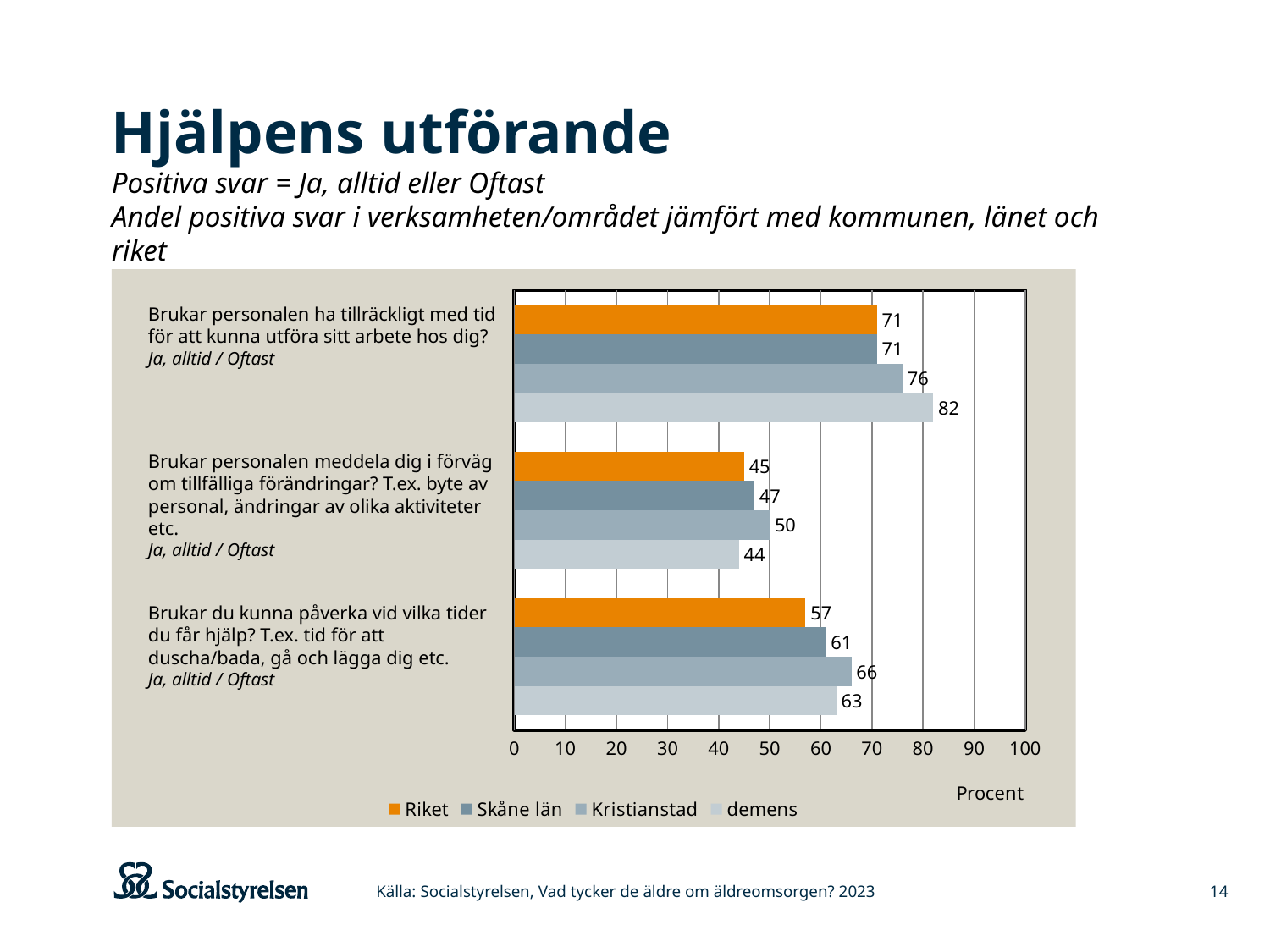
What is the difference between the 'demens' and 'Riket' values on the question 'Brukar personalen ha tillräckligt med tid för att kunna utföra sitt arbete hos dig?' 11 Which series has the highest value on the question 'Brukar personalen ha tillräckligt med tid för att kunna utföra sitt arbete hos dig?' demens What is the value for 'Kristianstad' on the question 'Brukar personalen meddela dig i förväg om tillfälliga förändringar?' 50 What is the value for 'Riket' on the question 'Brukar du kunna påverka vid vilka tider du får hjälp?' 57 Which series has the lowest value on the question 'Brukar personalen meddela dig i förväg om tillfälliga förändringar?' demens What is the value for 'demens' on the question 'Brukar personalen ha tillräckligt med tid för att kunna utföra sitt arbete hos dig?' 82 Is the value for 'Skåne län' on the question 'Brukar personalen meddela dig i förväg om tillfälliga förändringar?' greater or less than 50? less On the question 'Brukar du kunna påverka vid vilka tider du får hjälp?', which is larger: the value for 'Kristianstad' or the value for 'demens'? Kristianstad How many series does the legend list? 4 What is the label of the x axis? Procent What is the value for 'Skåne län' on the question 'Brukar du kunna påverka vid vilka tider du får hjälp?' 61 What kind of chart is shown on the slide? Bar chart